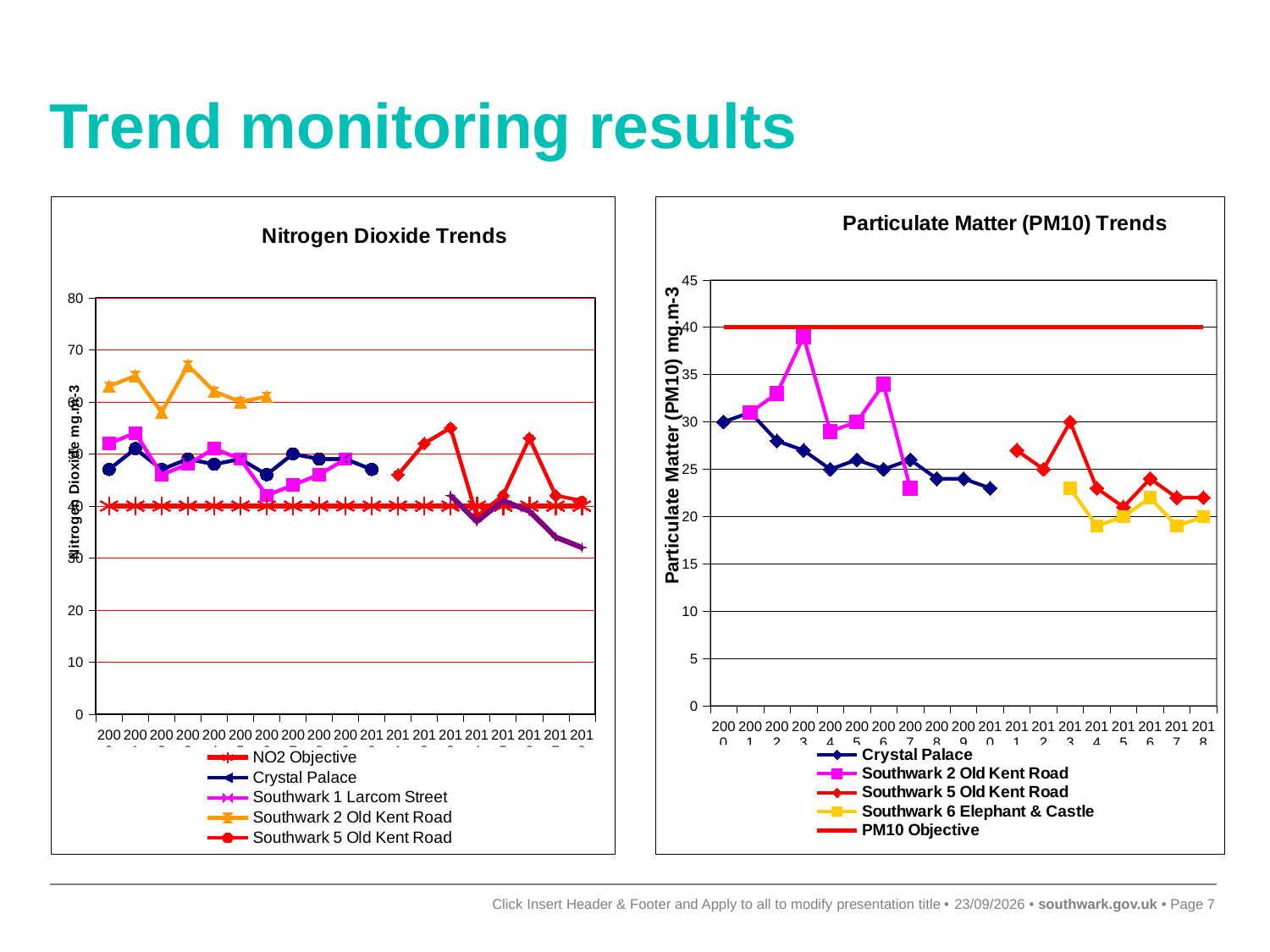
What type of chart is the Nitrogen Dioxide Trends chart? line chart In the Particulate Matter (PM10) Trends chart, which monitoring site series reaches the highest value? Southwark 2 Old Kent Road What is the title of the chart on the right of the slide? Particulate Matter (PM10) Trends How many series does the legend of the Particulate Matter (PM10) Trends chart list? 5 How many series does the legend of the Nitrogen Dioxide Trends chart list? 5 In the Particulate Matter (PM10) Trends chart, at what value does the PM10 Objective line sit? 40 In the Nitrogen Dioxide Trends chart, at what value does the NO2 Objective line sit? 40 In the Nitrogen Dioxide Trends chart, are the values for Southwark 2 Old Kent Road greater or less than 50? greater In the Particulate Matter (PM10) Trends chart, do the Crystal Palace values rise or fall from 2000 to 2010? fall What type of chart is the Particulate Matter (PM10) Trends chart? line chart In the Particulate Matter (PM10) Trends chart, are the values for Southwark 6 Elephant & Castle greater or less than 25? less In the Nitrogen Dioxide Trends chart, which monitoring site series has the highest values? Southwark 2 Old Kent Road